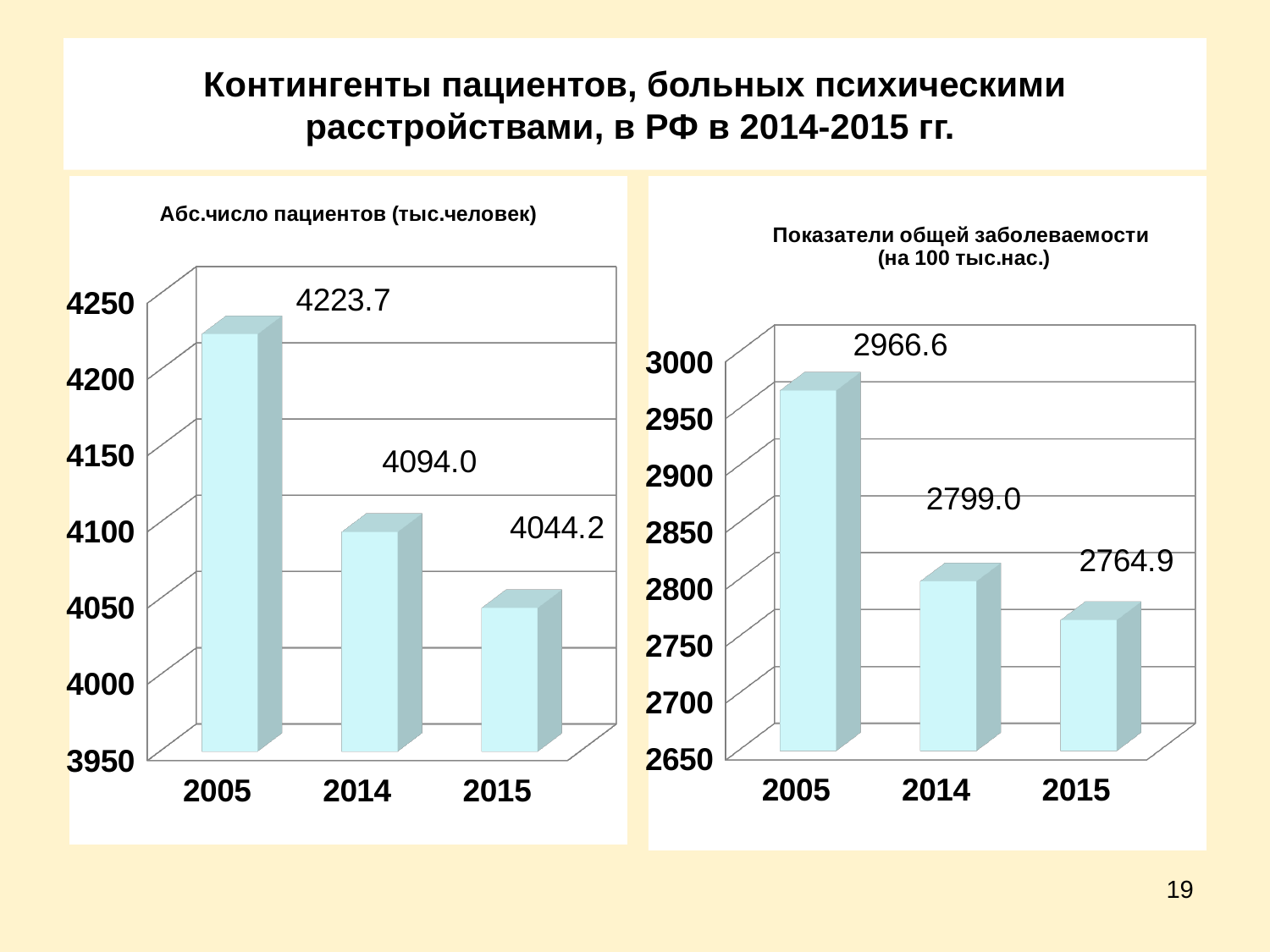
What type of chart is the right chart (Показатели общей заболеваемости)? bar chart In the right chart (Показатели общей заболеваемости), which is larger, the value for 2005 or the value for 2014? 2005 In the left chart (Абс.число пациентов), what is the value for 2005? 4223.7 In the right chart (Показатели общей заболеваемости), what is the difference between the 2014 and 2015 values? 34.1 In the right chart (Показатели общей заболеваемости), what is the value for 2014? 2799.0 In the right chart (Показатели общей заболеваемости), what is the value for 2015? 2764.9 In the left chart (Абс.число пациентов), how many years are shown on the x axis? 3 In the left chart (Абс.число пациентов), do the values rise or fall from 2005 to 2015? fall In the left chart (Абс.число пациентов), what is the difference between the 2005 and 2015 values? 179.5 In the left chart (Абс.число пациентов), what is the value for 2015? 4044.2 In the right chart (Показатели общей заболеваемости), which year has the lowest value? 2015 In the left chart (Абс.число пациентов), which year has the highest value? 2005